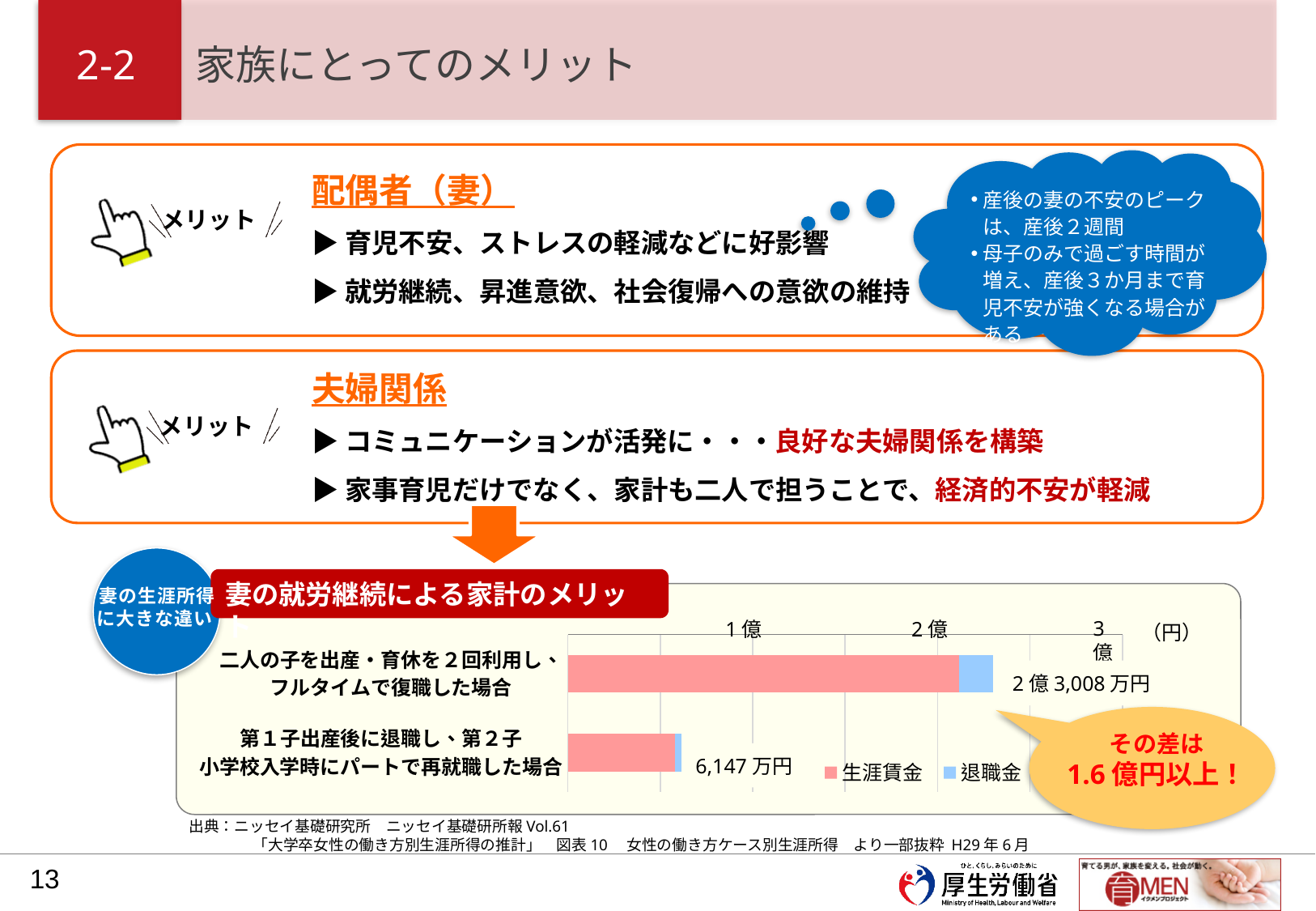
Which case has the higher total lifetime income in the bar chart? 二人の子を出産・育休を２回利用し、フルタイムで復職した場合 In the bar for 二人の子を出産・育休を２回利用し、フルタイムで復職した場合, which series is larger, 生涯賃金 or 退職金? 生涯賃金 Is the total for 第１子出産後に退職し、第２子小学校入学時にパートで再就職した場合 greater or less than 1億 on the axis? less Which case has the lower total lifetime income in the bar chart? 第１子出産後に退職し、第２子小学校入学時にパートで再就職した場合 What is the difference between the two total lifetime incomes shown in the bar chart (2億3,008万円 and 6,147万円)? 1億6,861万円 How many series does the legend of the bar chart list? 2 What kind of chart is shown at the bottom of the slide? bar chart What are the two series listed in the legend of the bar chart? 生涯賃金, 退職金 How many categories (cases) are plotted in the bar chart? 2 What is the total lifetime income shown for 二人の子を出産・育休を２回利用し、フルタイムで復職した場合? 2億3,008万円 What is the total lifetime income shown for 第１子出産後に退職し、第２子小学校入学時にパートで再就職した場合? 6,147万円 Is the total for 二人の子を出産・育休を２回利用し、フルタイムで復職した場合 greater or less than 2億 on the axis? greater